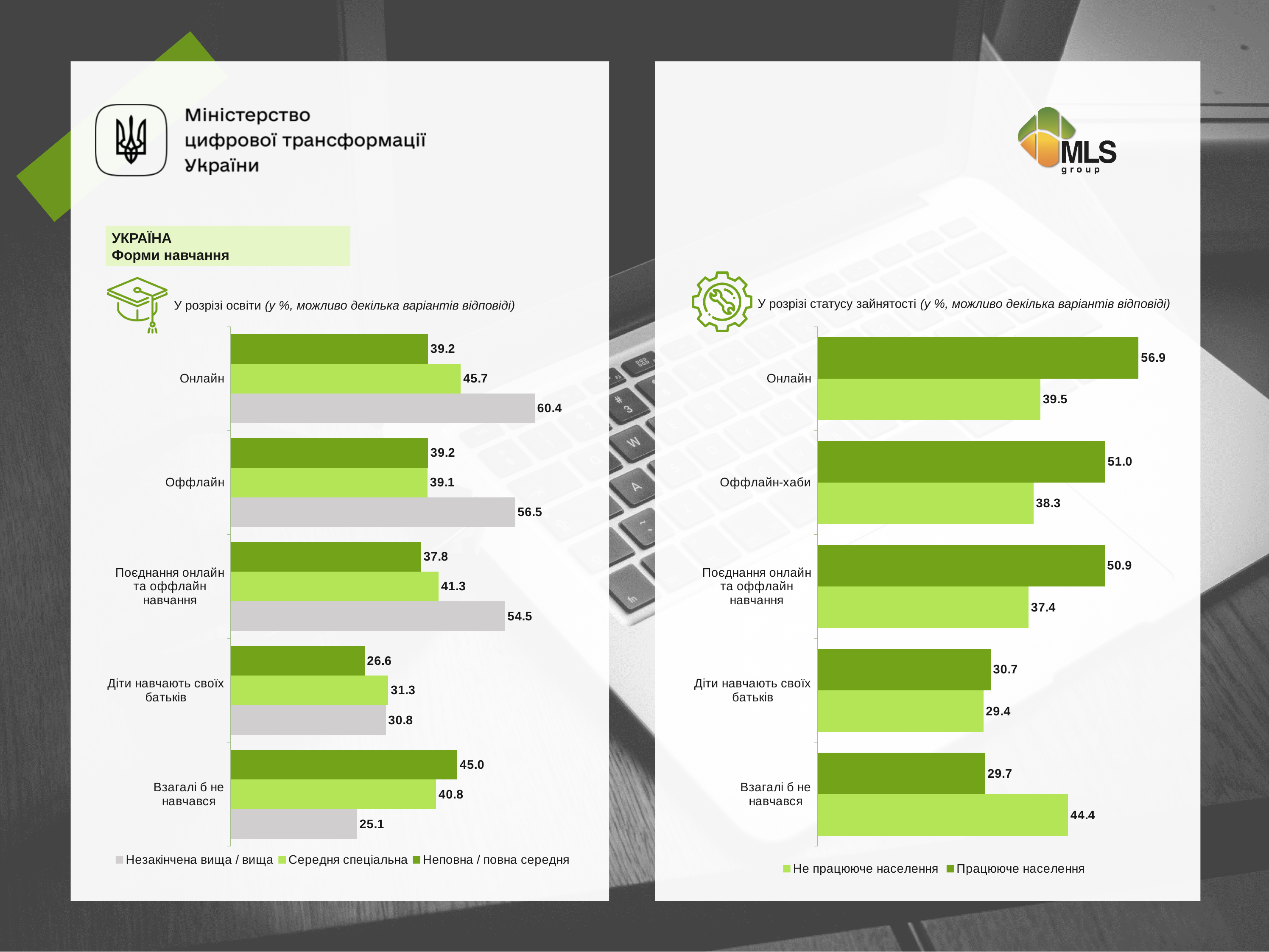
In the right chart (У розрізі статусу зайнятості), which category has the highest value in the Працююче населення series? Онлайн In the right chart (У розрізі статусу зайнятості), what is the value for Взагалі б не навчався in the Не працююче населення series? 44.4 In the left chart (У розрізі освіти), what is the value for Взагалі б не навчався in the Неповна / повна середня series? 45.0 In the left chart (У розрізі освіти), what is the value for Онлайн in the Незакінчена вища / вища series? 60.4 In the left chart (У розрізі освіти), which category has the lowest value in the Незакінчена вища / вища series? Взагалі б не навчався How many series does the legend of the left chart (У розрізі освіти) list? 3 In the right chart (У розрізі статусу зайнятості), which is larger for Взагалі б не навчався: Не працююче населення or Працююче населення? Не працююче населення In the left chart (У розрізі освіти), what is the difference between the Незакінчена вища / вища and Неповна / повна середня values for Оффлайн? 17.3 In the right chart (У розрізі статусу зайнятості), what is the difference between the Працююче населення and Не працююче населення values for Онлайн? 17.4 In the right chart (У розрізі статусу зайнятості), what is the value for Оффлайн-хаби in the Працююче населення series? 51.0 How many categories are shown in the right chart (У розрізі статусу зайнятості)? 5 In the left chart (У розрізі освіти), which category has the highest value in the Середня спеціальна series? Онлайн